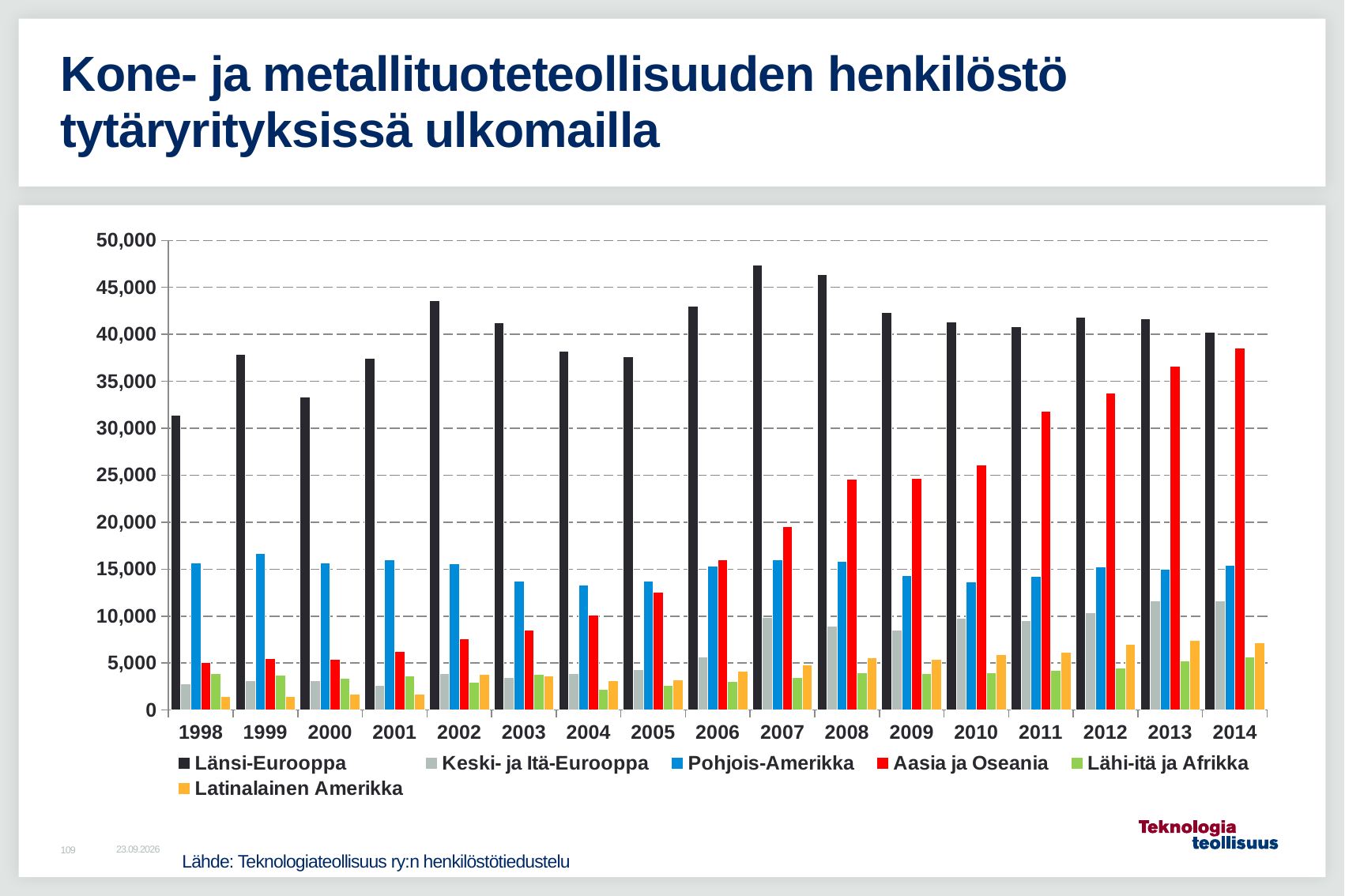
Is the value for Keski- ja Itä-Eurooppa in 2013 greater or less than 10,000? greater In which year is the value for Aasia ja Oseania highest? 2014 How many years are shown on the x axis of the chart? 17 How many series does the legend list? 6 Does the value for Aasia ja Oseania generally rise or fall from 1998 to 2014? rise Is the value for Länsi-Eurooppa in 1998 greater or less than 30,000? greater In 2014, which is larger: Länsi-Eurooppa or Aasia ja Oseania? Länsi-Eurooppa What kind of chart is shown on the slide? bar chart Is the value for Aasia ja Oseania in 2011 greater or less than 30,000? greater What colour represents Aasia ja Oseania in the chart? red In 1998, which is larger: Pohjois-Amerikka or Aasia ja Oseania? Pohjois-Amerikka